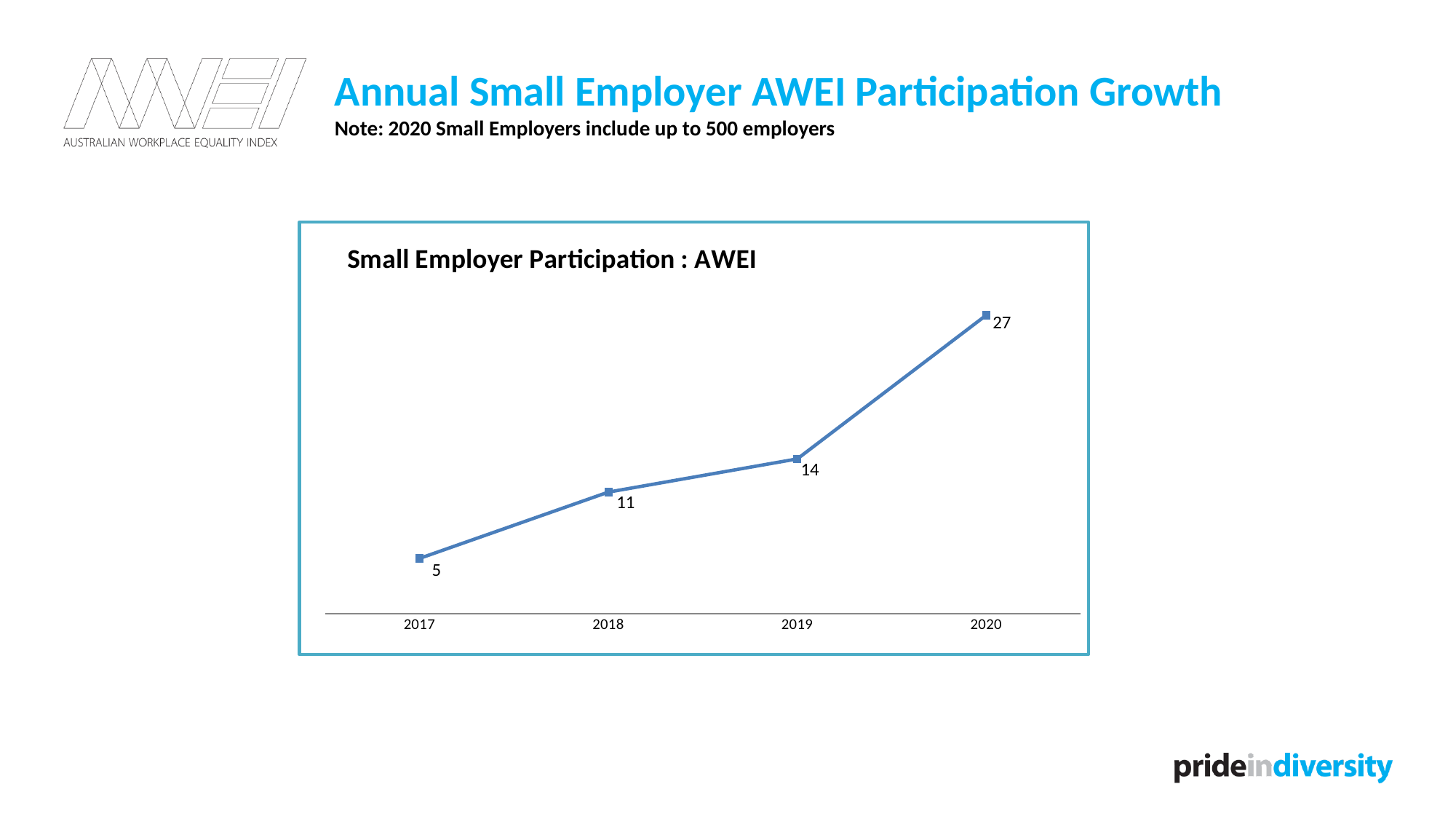
What kind of chart is shown? line chart Which year has the lowest value? 2017 How many years are plotted on the chart? 4 What is the difference between the values for 2020 and 2019? 13 Which is larger, the value for 2019 or the value for 2018? 2019 What is the value for 2019? 14 What is the value for 2018? 11 What is the value for 2020? 27 Do the values rise or fall from 2017 to 2020? rise Which year has the highest value? 2020 What is the difference between the values for 2018 and 2017? 6 What is the value for 2017? 5